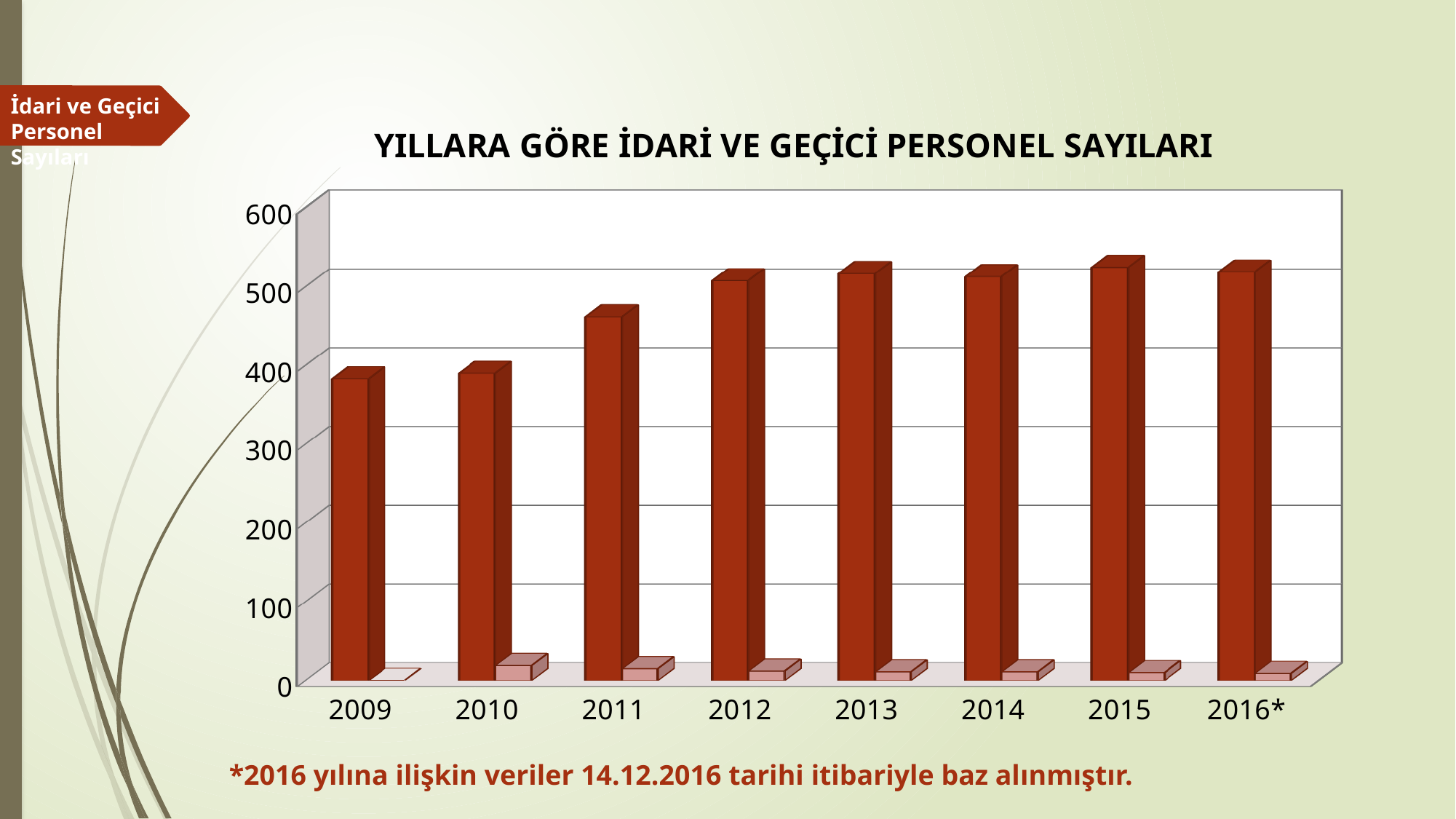
What is the title of the chart? YILLARA GÖRE İDARİ VE GEÇİCİ PERSONEL SAYILARI Which year label on the x axis is marked with an asterisk? 2016* What kind of chart is shown on the slide? bar chart Is the value of the tall dark red bar for 2011 greater or less than 400? greater Is the value of the tall dark red bar for 2011 greater or less than 500? less Do the dark red bars rise or fall from 2009 to 2013? rise Is the value of the tall dark red bar for 2009 greater or less than 400? less Which year has the larger dark red bar, 2011 or 2012? 2012 How many years are shown on the x axis of the chart? 8 Which year has the larger dark red bar, 2009 or 2011? 2011